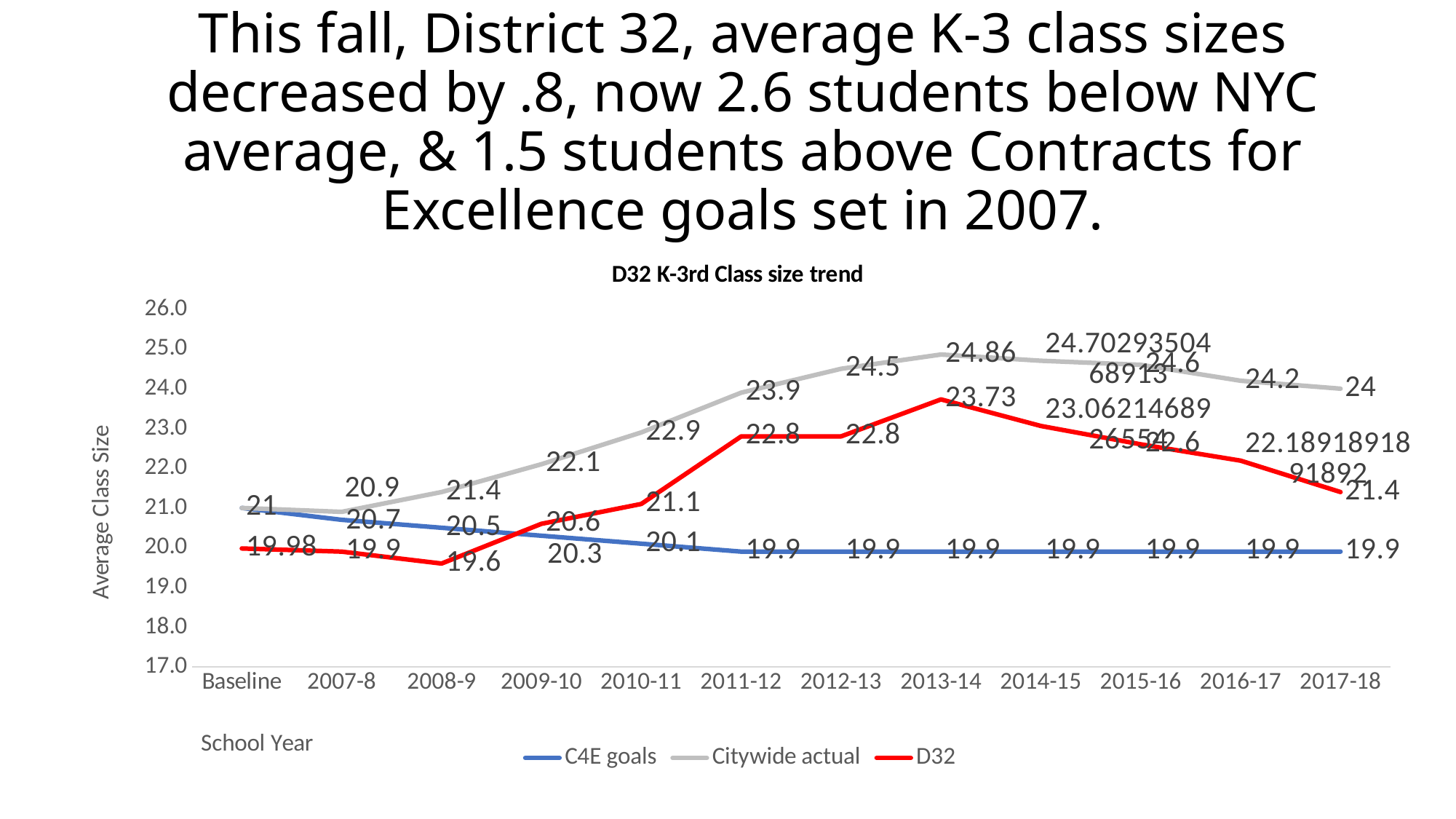
What is the D32 value for 2017-18? 21.4 Which is larger in 2011-12, the Citywide actual value or the D32 value? Citywide actual What is the Citywide actual value for 2013-14? 24.86 What is the title of the vertical axis of the chart? Average Class Size How many school-year categories are shown on the x axis of the chart? 12 What is the D32 value for 2008-9? 19.6 How many series does the legend list in the D32 K-3rd Class size trend chart? 3 What kind of chart is shown on the slide? line chart In which school year does the D32 series reach its highest value? 2013-14 What is the Citywide actual value for 2017-18? 24 What is the difference between the Citywide actual and D32 values for 2017-18? 2.6 In which school year does the D32 series reach its lowest value? 2008-9